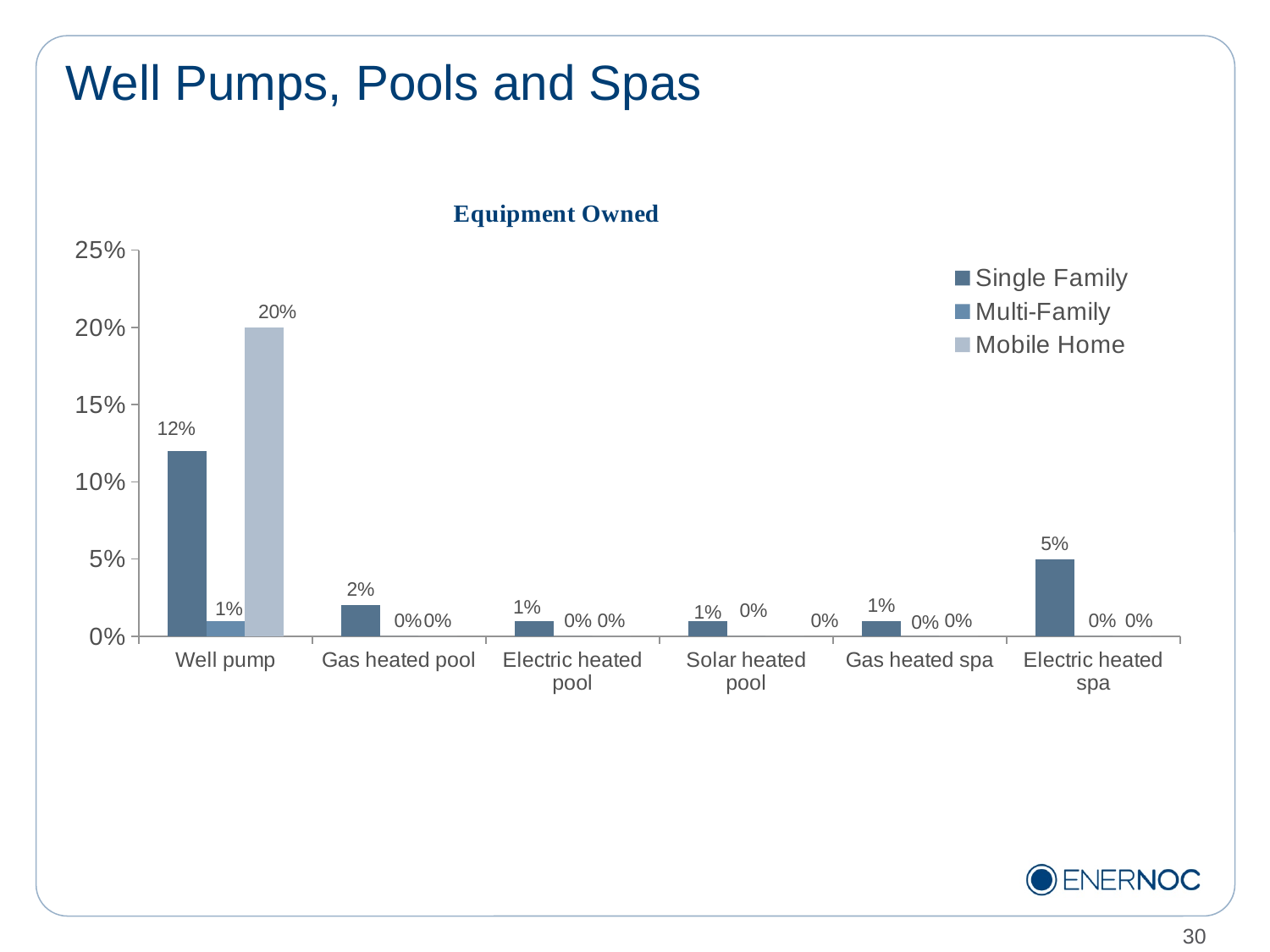
How many categories are shown on the x axis? 6 How many series does the legend list? 3 What is the Multi-Family value for Well pump? 1% Which is larger for Well pump, the Single Family value or the Mobile Home value? Mobile Home What is the Single Family value for Electric heated spa? 5% What is the Mobile Home value for Well pump? 20% What is the Single Family value for Well pump? 12% What kind of chart is shown on the slide? Bar chart What is the title of the chart? Equipment Owned What is the difference between the Single Family values for Electric heated spa and Gas heated pool? 3% What is the difference between the Mobile Home and Single Family values for Well pump? 8% Which category has the highest Single Family value? Well pump